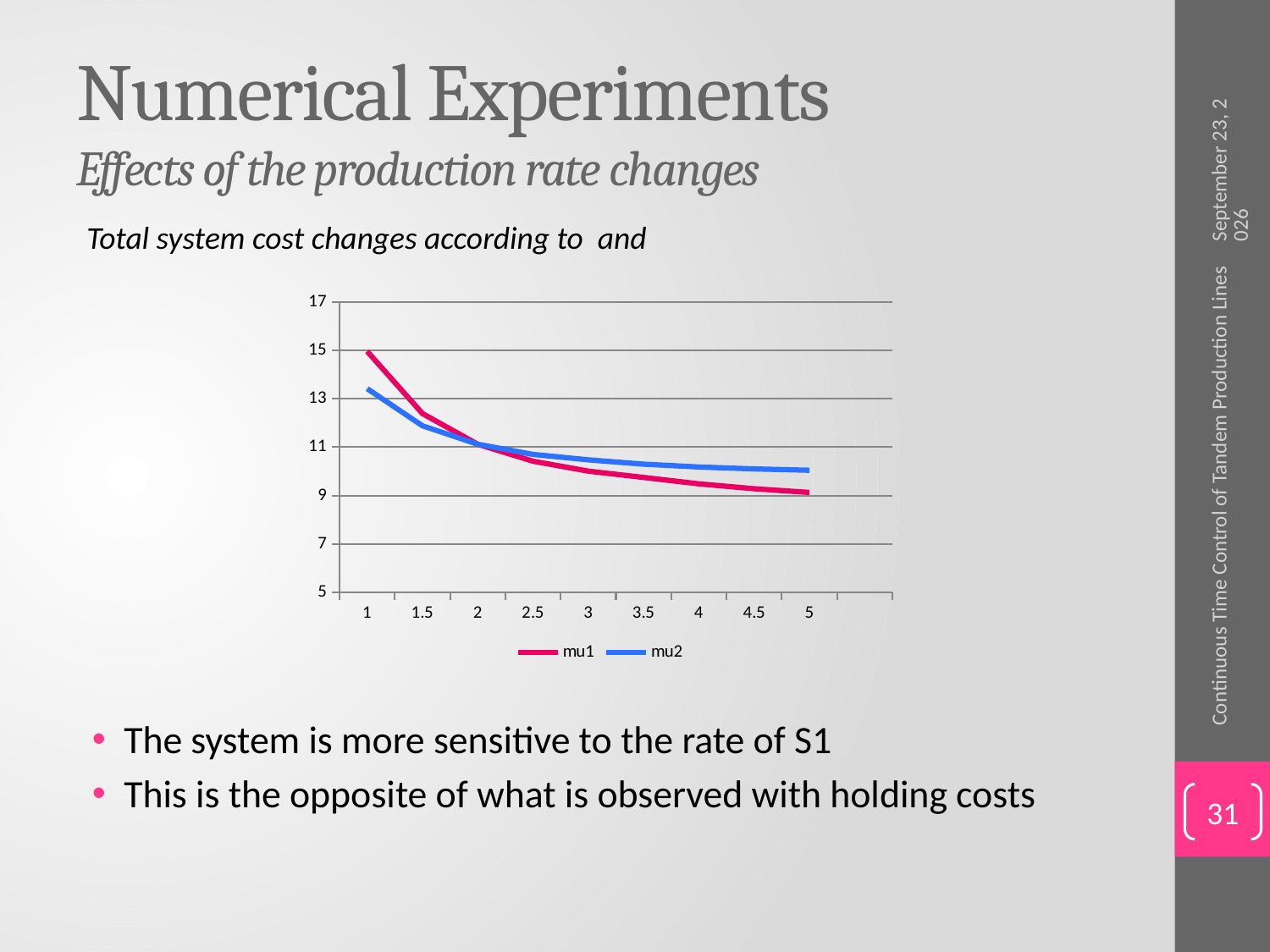
How many labelled points are there along the x axis of the chart? 9 What are the names of the two series in the chart legend? mu1 and mu2 Is the value of mu2 at x = 5 greater or less than 9? greater How many series does the chart legend list? 2 Which colour is used for the mu2 series line in the chart? blue Do the values of the mu1 series rise or fall as the x-axis value increases from 1 to 5? fall Is the value of mu1 at x = 5 greater or less than 11? less Do the values of the mu2 series rise or fall as the x-axis value increases from 1 to 5? fall At x = 5, which series has the larger value, mu1 or mu2? mu2 Is the value of mu1 at x = 1 greater or less than 13? greater At x = 1, which series has the larger value, mu1 or mu2? mu1 What kind of chart is shown on the slide? line chart